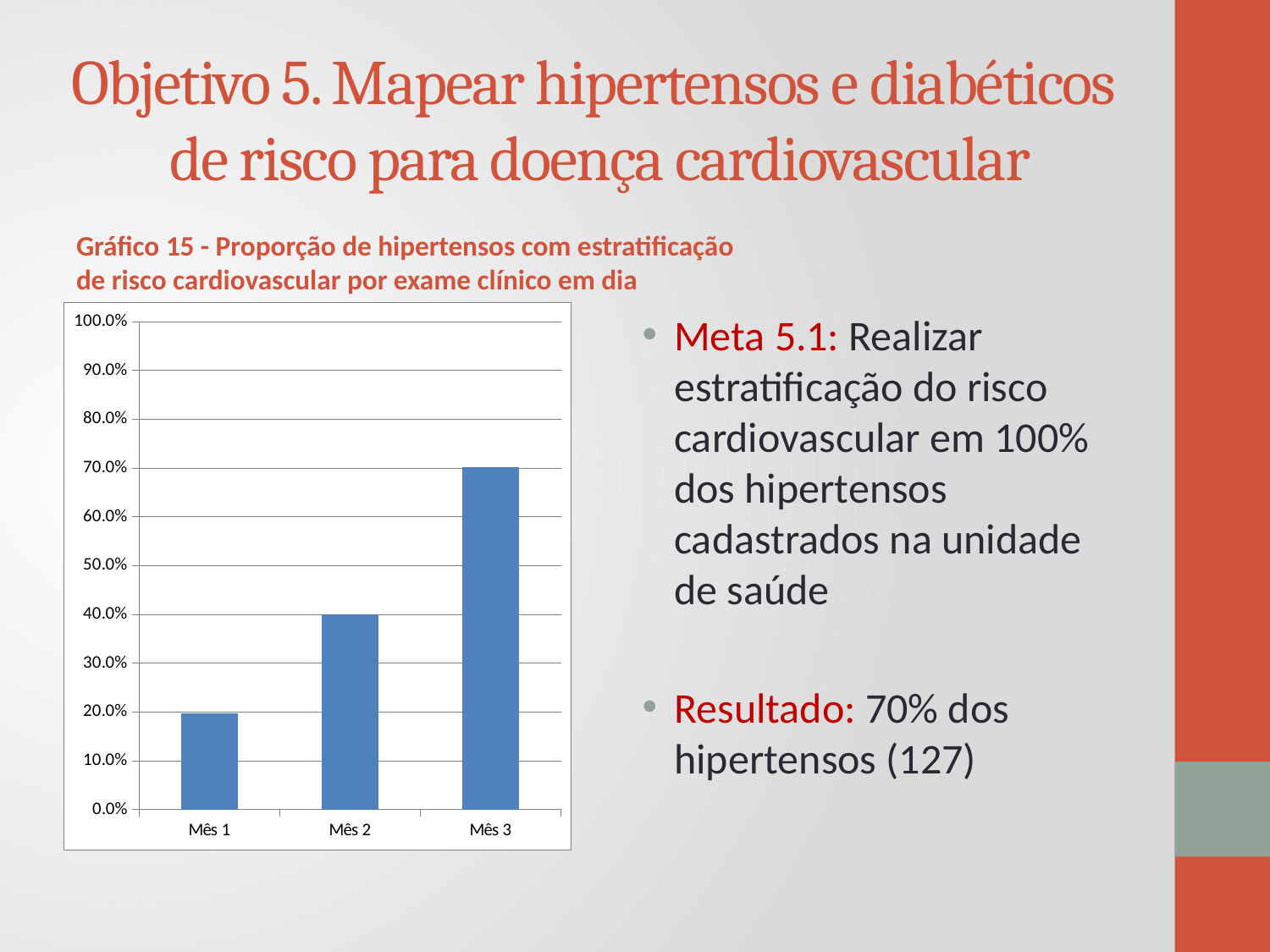
Is the value for Mês 3 greater or less than 80.0%? less Is the value for Mês 3 greater or less than 60.0%? greater Is the value for Mês 1 greater or less than 10.0%? greater Which is larger, the value for Mês 2 or the value for Mês 3? Mês 3 Which month has the highest bar in the chart? Mês 3 What type of chart is shown on the slide? bar chart Do the values rise or fall from Mês 1 to Mês 3? rise How many categories are shown on the x axis of the chart? 3 Which month has the lowest bar in the chart? Mês 1 What is the title of the chart on the slide? Gráfico 15 - Proporção de hipertensos com estratificação de risco cardiovascular por exame clínico em dia